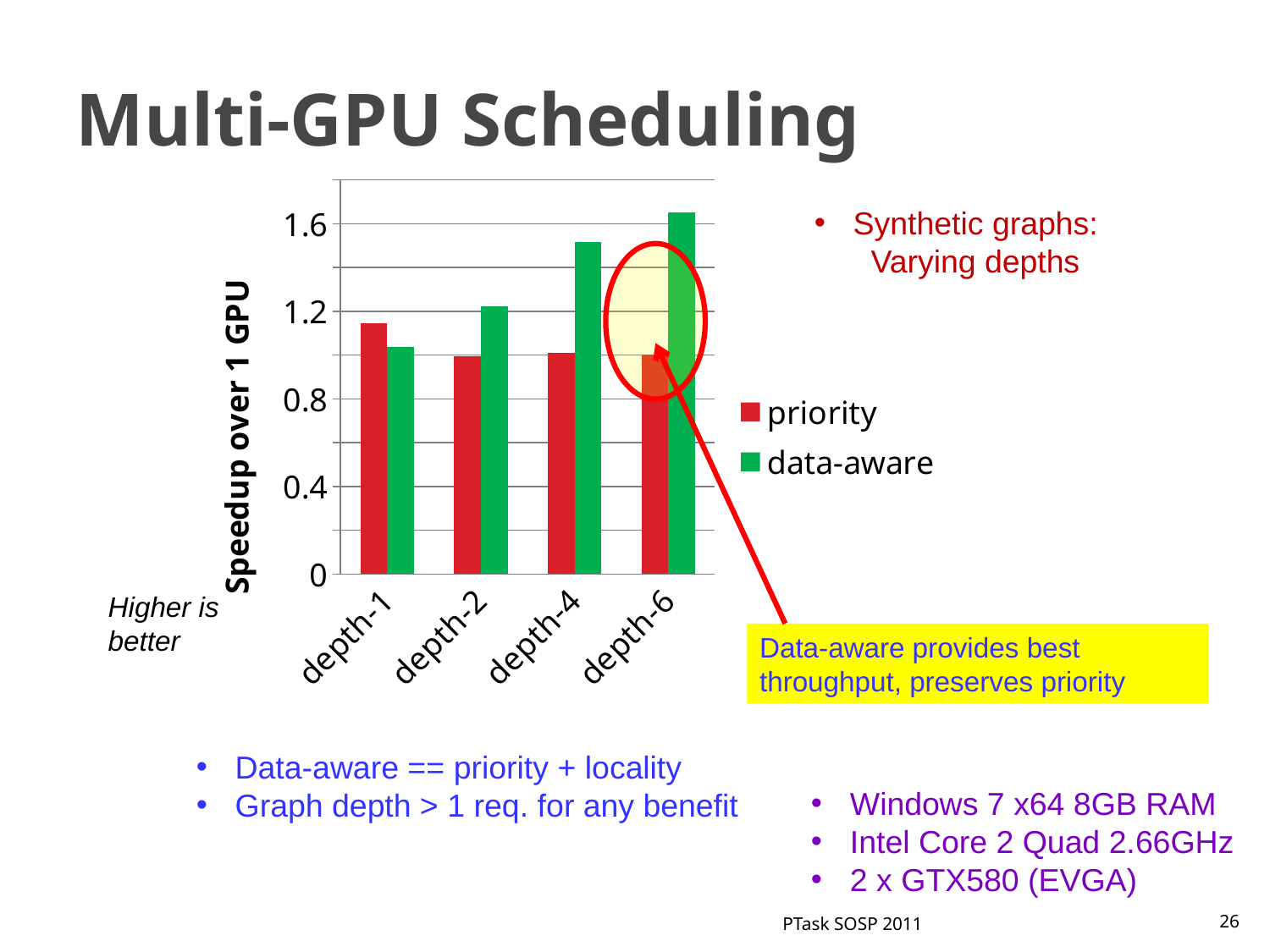
For which depth is the data-aware speedup lowest? depth-1 How many depth categories are plotted on the x axis? 4 At depth-4, which series has the larger speedup, priority or data-aware? data-aware Which series is listed second in the legend? data-aware At depth-1, which series has the larger speedup, priority or data-aware? priority For which depth is the data-aware speedup highest? depth-6 Is the data-aware speedup for depth-4 greater or less than 1.2? greater What kind of chart is shown on the slide? bar chart What is the title of the vertical axis? Speedup over 1 GPU How many series does the legend list? 2 Is the priority speedup for depth-2 greater or less than 1.2? less Does the data-aware speedup rise or fall as depth increases from depth-1 to depth-6? rise